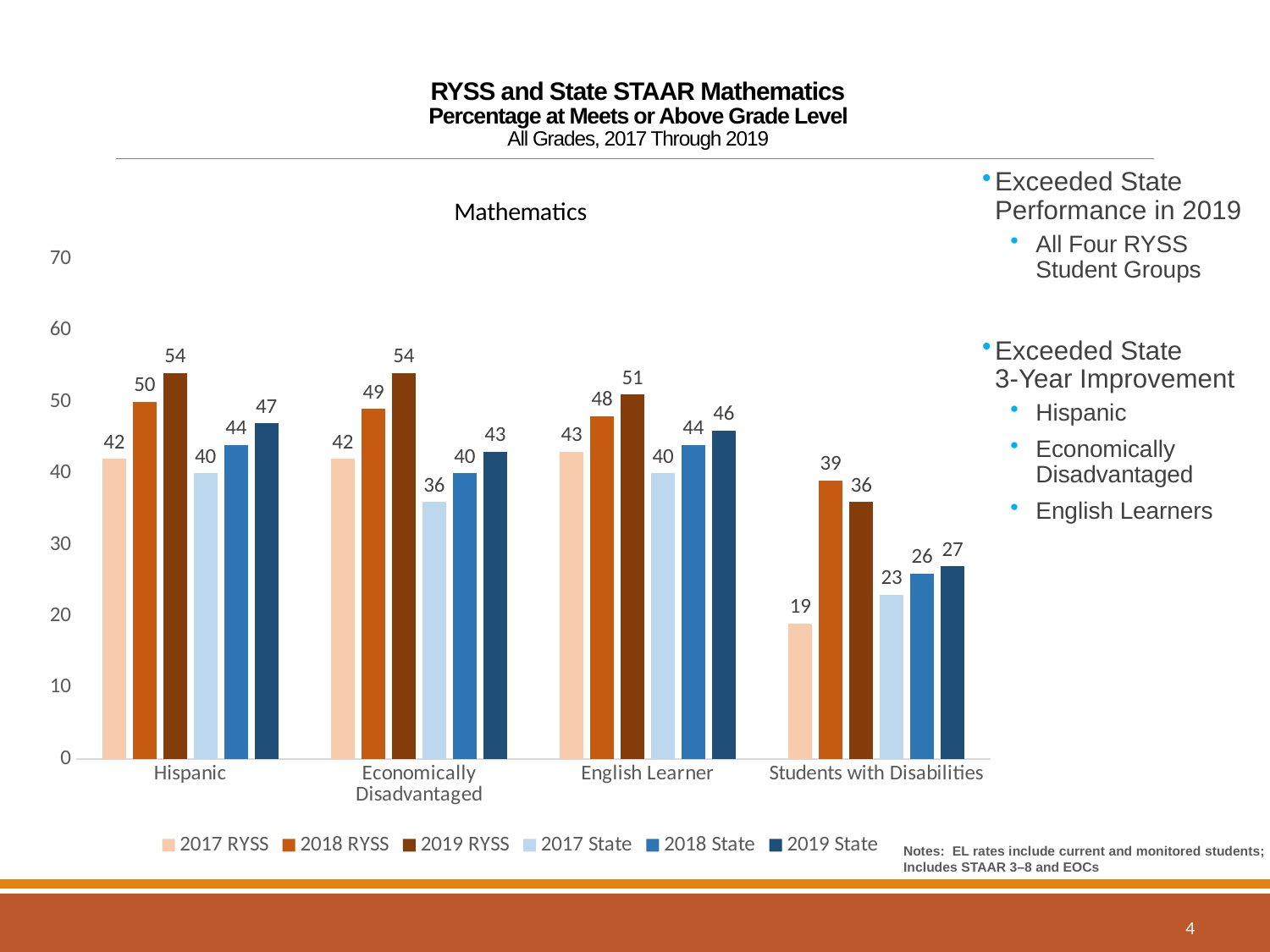
What kind of chart is shown on the slide? Bar chart What is the 2017 State value for Economically Disadvantaged students? 36 Do the RYSS values for Hispanic students rise or fall from 2017 to 2019? Rise What is the title shown above the plot area of the chart? Mathematics How many series does the legend list? 6 What is the 2019 RYSS value for Hispanic students? 54 Which is larger for Students with Disabilities: the 2019 RYSS value or the 2019 State value? 2019 RYSS What is the difference between the 2019 RYSS and 2017 RYSS values for Students with Disabilities? 17 Which category has the lowest 2017 RYSS value? Students with Disabilities What is the difference between the 2019 RYSS and 2019 State values for English Learner? 5 How many categories are shown on the x axis? 4 What is the 2018 RYSS value for Students with Disabilities? 39